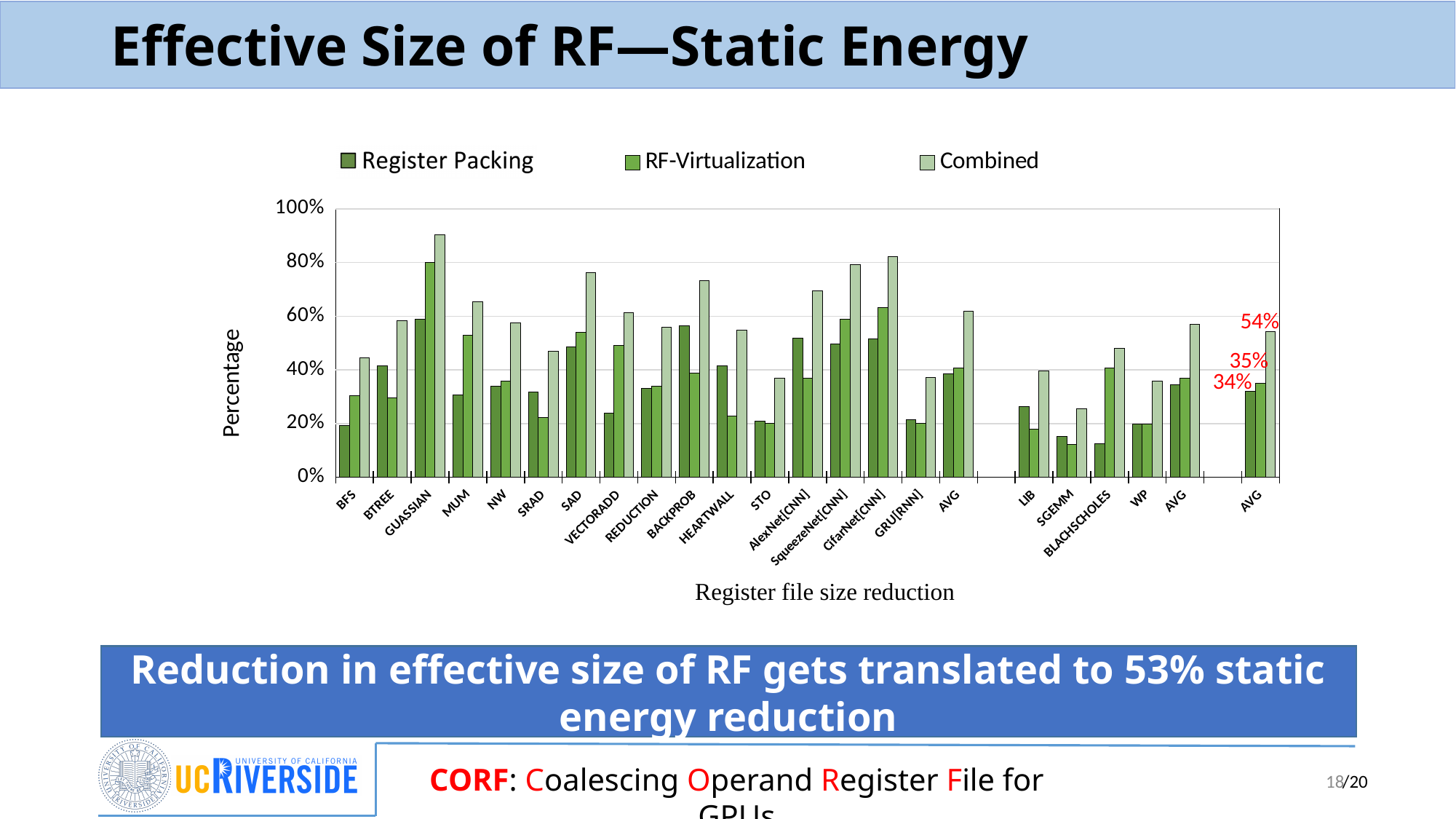
How many series does the chart legend list? 3 What is the Combined value for the rightmost AVG group? 54% What is the RF-Virtualization value for the rightmost AVG group? 35% What is the label on the vertical axis of the chart? Percentage Which is larger, the Combined value for GUASSIAN or the Combined value for MUM? GUASSIAN Which category has the highest Combined bar? GUASSIAN What is the Register Packing value for the rightmost AVG group? 34% In the rightmost AVG group, what is the difference between the Combined value and the Register Packing value? 20% Which category has the lowest Combined bar? SGEMM Is the Combined value for GUASSIAN greater or less than 80%? greater What type of chart is shown on the slide? bar chart